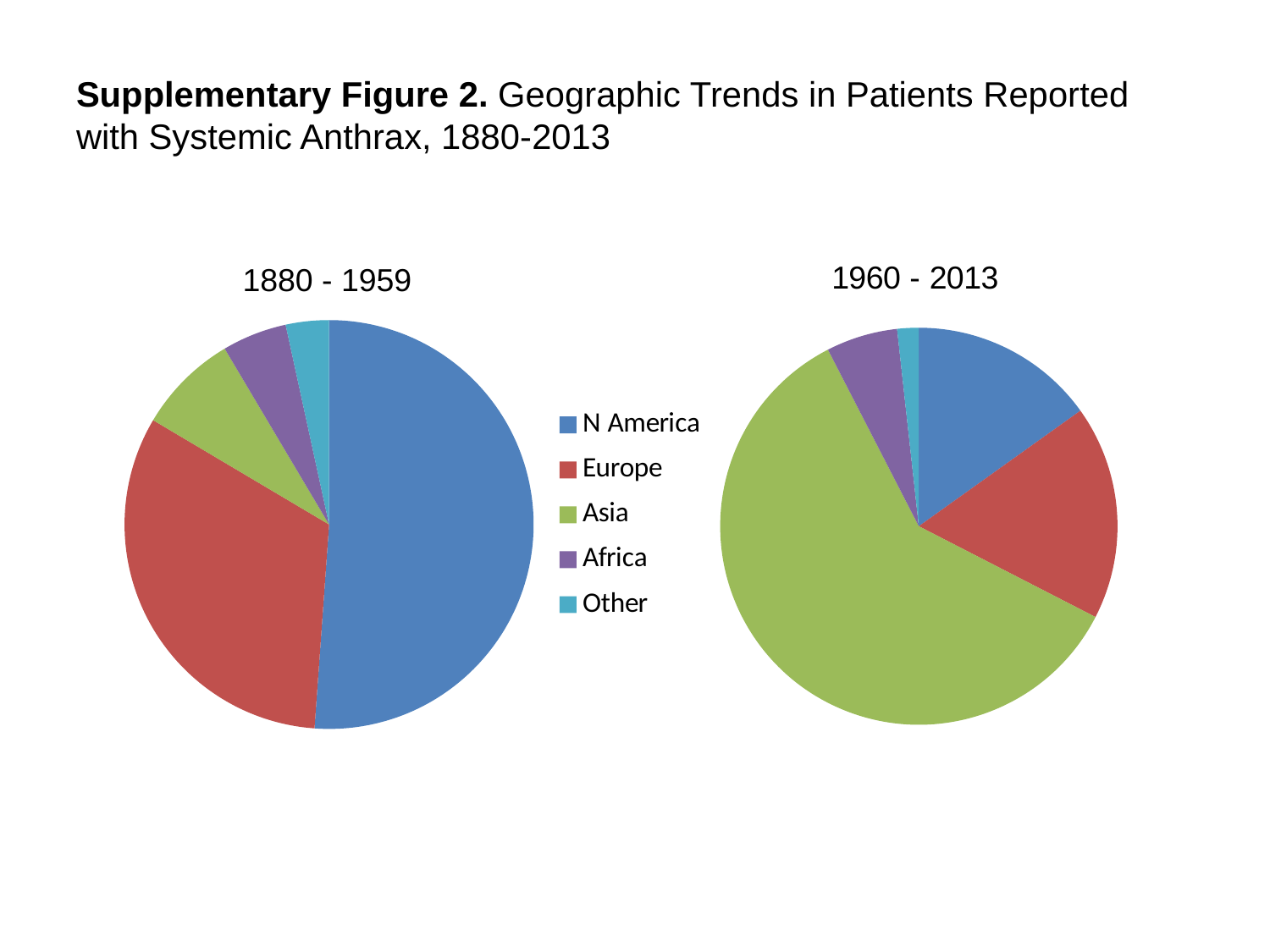
How many slices does the 1960 - 2013 pie chart have? 5 In the 1960 - 2013 chart, which region has the smallest slice? Other What kind of chart is the 1960 - 2013 chart? pie chart In the 1880 - 1959 chart, which region has the smallest slice? Other In the 1880 - 1959 chart, which slice is larger, Europe or Asia? Europe Which colour represents Asia in the legend? green In the 1880 - 1959 chart, which slice is larger, N America or Europe? N America What kind of chart is the 1880 - 1959 chart? pie chart In the 1880 - 1959 chart, which region has the largest slice? N America How many entries does the legend list? 5 In the 1960 - 2013 chart, which slice is larger, Asia or Europe? Asia In the 1960 - 2013 chart, which region has the largest slice? Asia